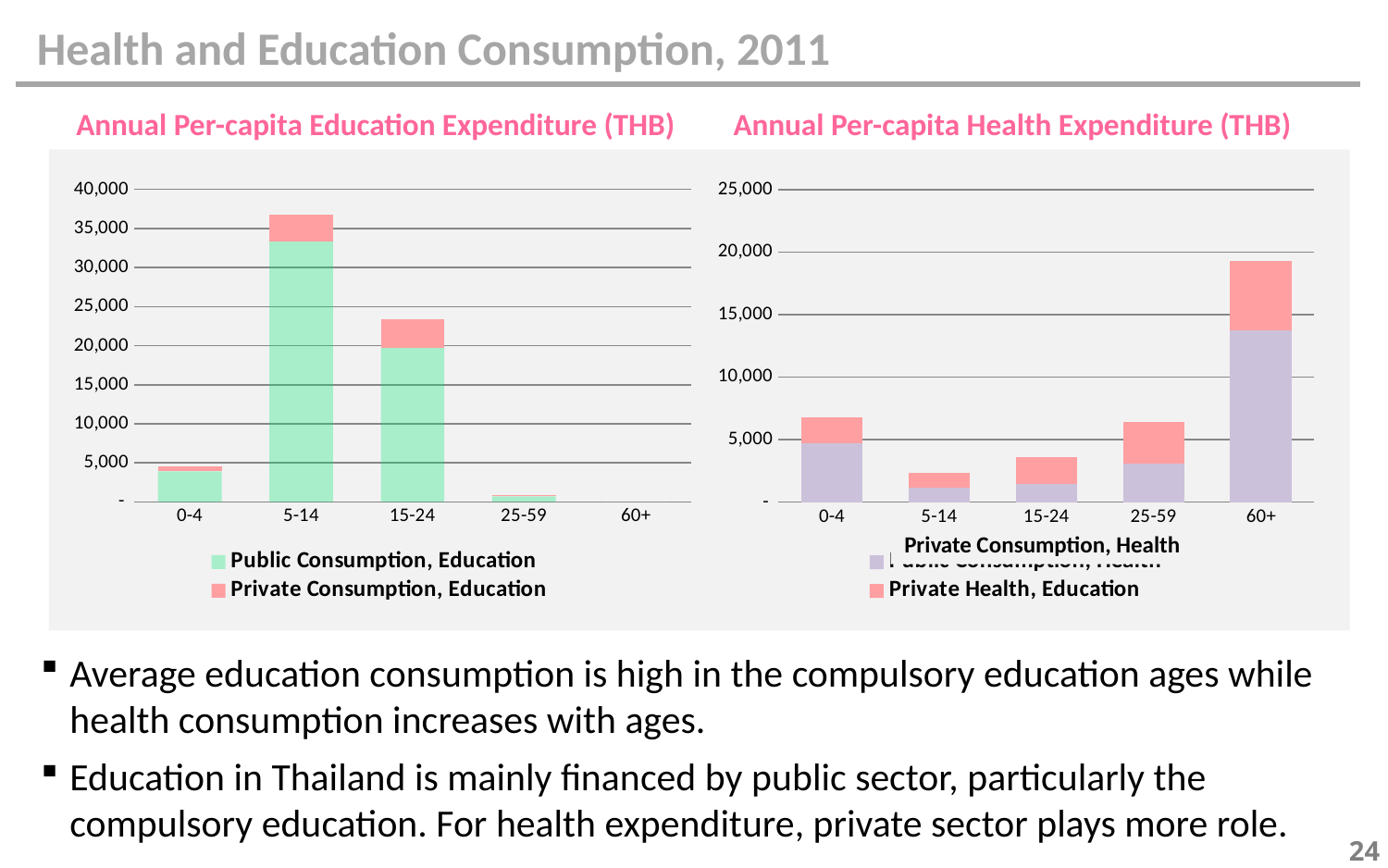
On the Annual Per-capita Health Expenditure chart, which age group has the highest total bar? 60+ On the Annual Per-capita Health Expenditure chart, which has the larger total bar, 15-24 or 25-59? 25-59 On the Annual Per-capita Education Expenditure chart, do the total values rise or fall from the 5-14 group to the 60+ group? fall On the Annual Per-capita Education Expenditure chart, is the total for the 5-14 age group greater or less than 35,000? greater On the Annual Per-capita Education Expenditure chart, which age group has the highest total bar? 5-14 On the Annual Per-capita Health Expenditure chart, is the total for the 60+ age group greater or less than 15,000? greater On the Annual Per-capita Health Expenditure chart, is the total for the 0-4 age group greater or less than 5,000? greater On the Annual Per-capita Health Expenditure chart, which age group has the lowest total bar? 5-14 What kind of chart is the Annual Per-capita Education Expenditure chart? stacked bar chart How many age groups are shown on the x axis of the Annual Per-capita Education Expenditure chart? 5